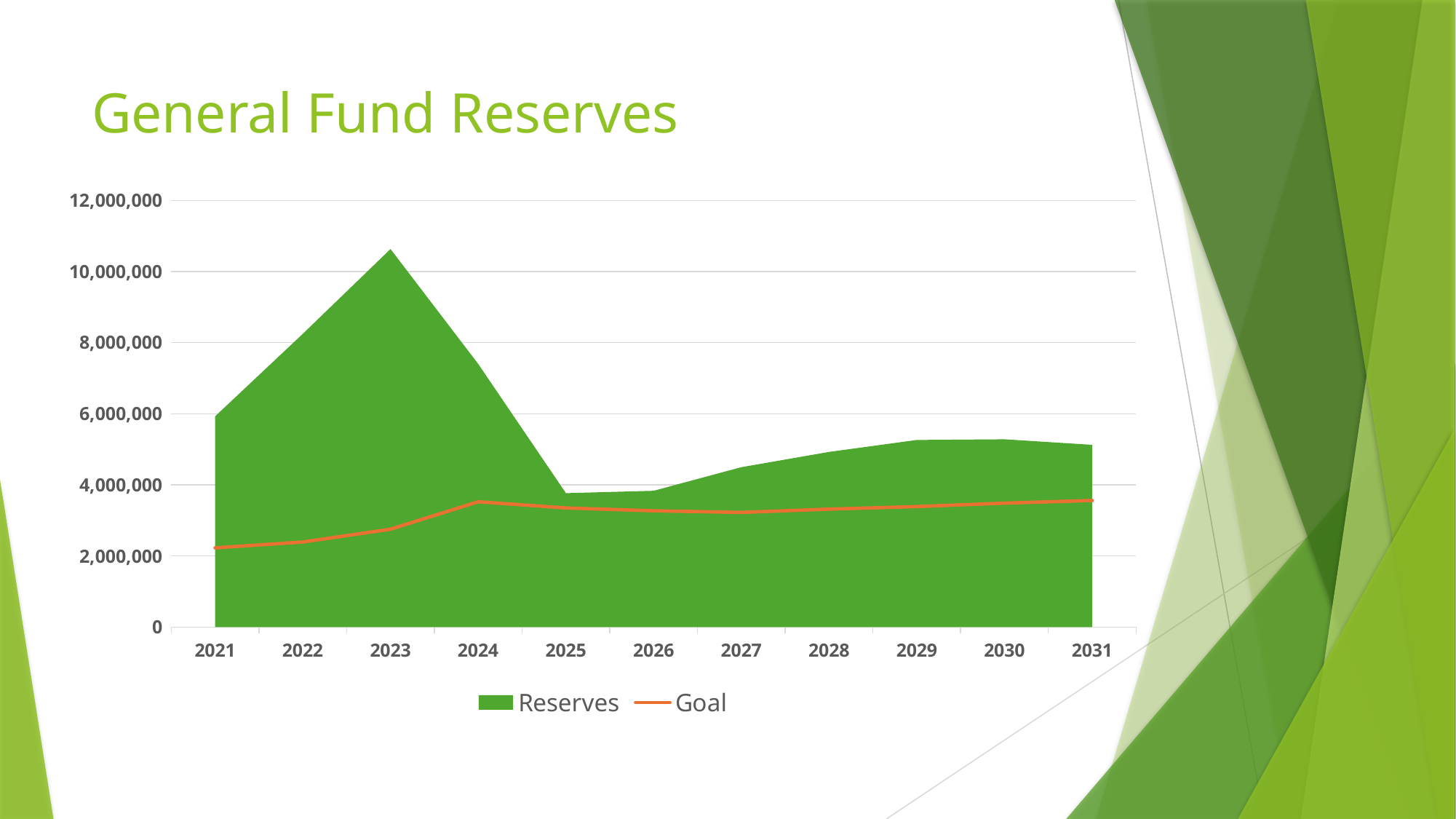
Is the value of Reserves in 2023 greater or less than 10,000,000? greater What colour is the Goal line? Orange How many years are shown on the x axis? 11 Which is larger in 2023, Reserves or Goal? Reserves In which year is the Goal lowest? 2021 How many series does the legend list? 2 What kind of chart is shown on the slide? An area chart with a line series In which year are Reserves highest? 2023 Do Reserves rise or fall from 2025 to 2029? rise Is the value of Reserves in 2021 greater or less than 4,000,000? greater What is the title of the chart? General Fund Reserves Is the Goal value in 2024 greater or less than 4,000,000? less